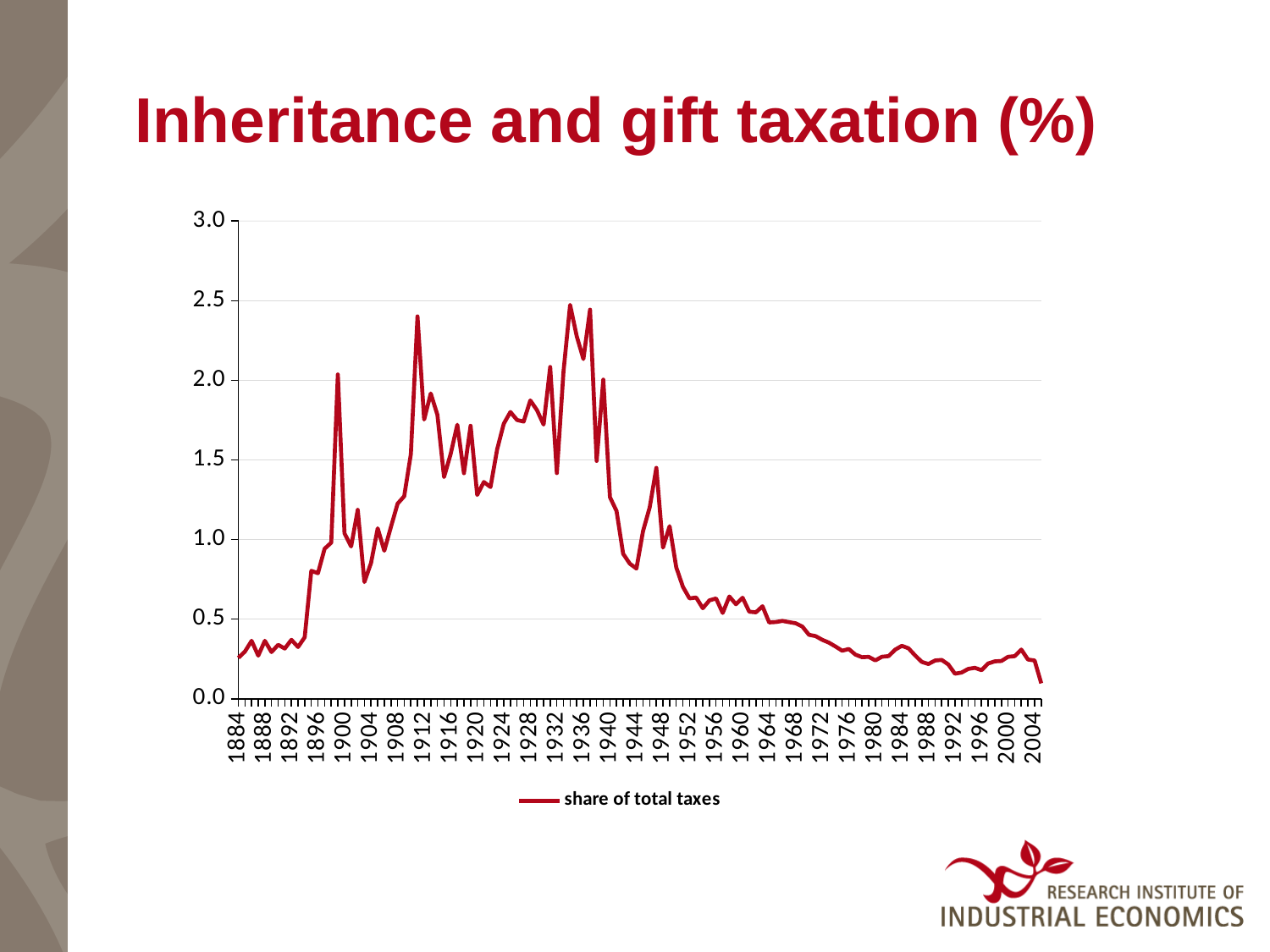
Is the value for 1900 greater or less than 1.5? less Is the value for 1968 greater or less than 1.0? less What is the title of the chart? Inheritance and gift taxation (%) Does the share of total taxes generally rise or fall between 1948 and 2004? fall What kind of chart is shown on the slide? line chart What is the name of the series shown in the legend? share of total taxes Is the value for 1976 greater or less than 0.5? less How many series does the legend list? 1